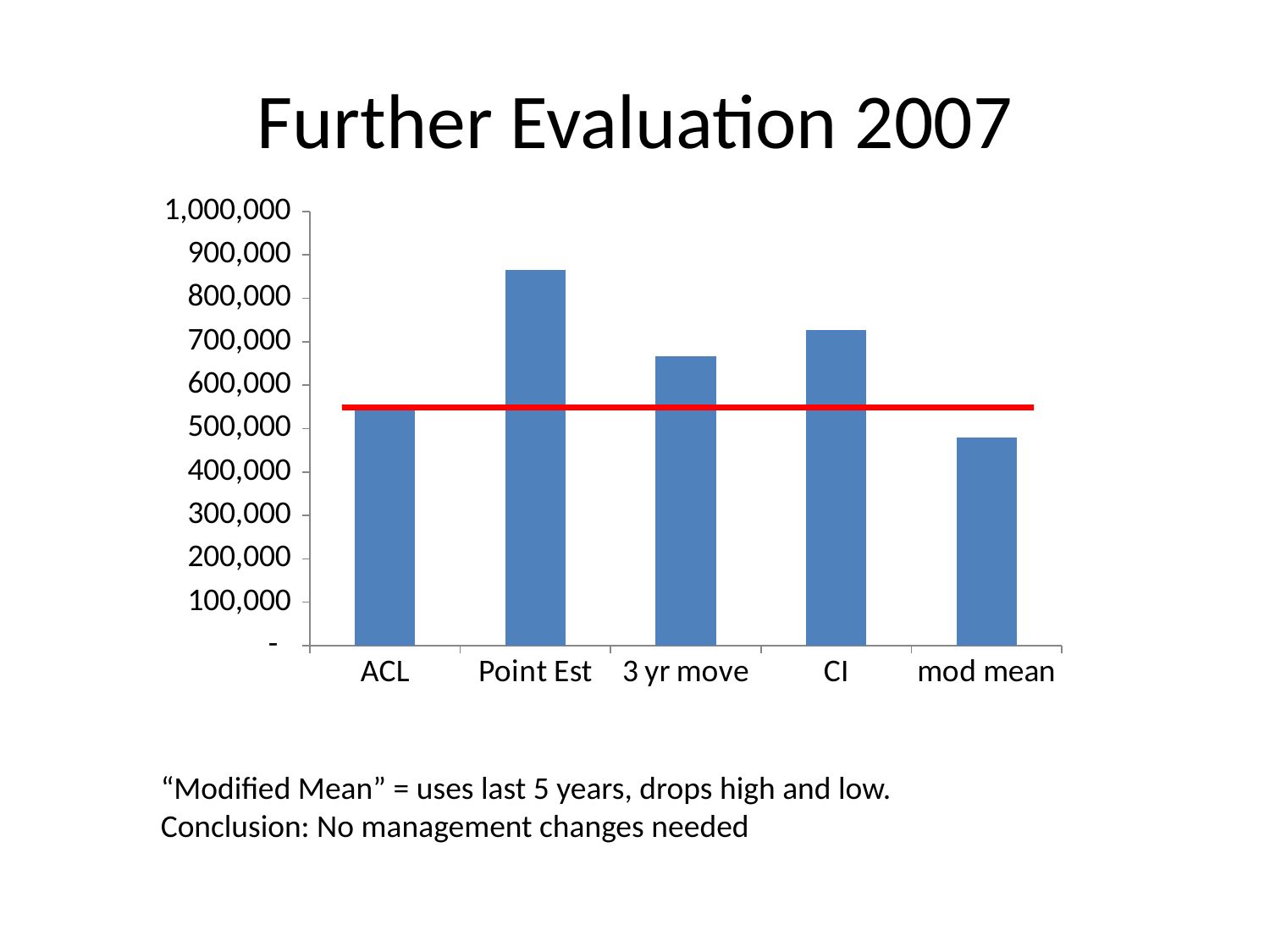
What is the title of the slide containing the chart? Further Evaluation 2007 What colour is the horizontal reference line drawn across the chart? red Which is larger, the value for ACL or the value for mod mean? ACL Is the value for 3 yr move greater or less than 600,000? greater Is the value for Point Est greater or less than 800,000? greater Which category has the highest bar? Point Est Is the value for mod mean greater or less than 500,000? less Which is larger, the value for CI or the value for 3 yr move? CI What kind of chart is shown on the slide? bar chart Which category has the lowest bar? mod mean How many categories are shown on the x axis of the chart? 5